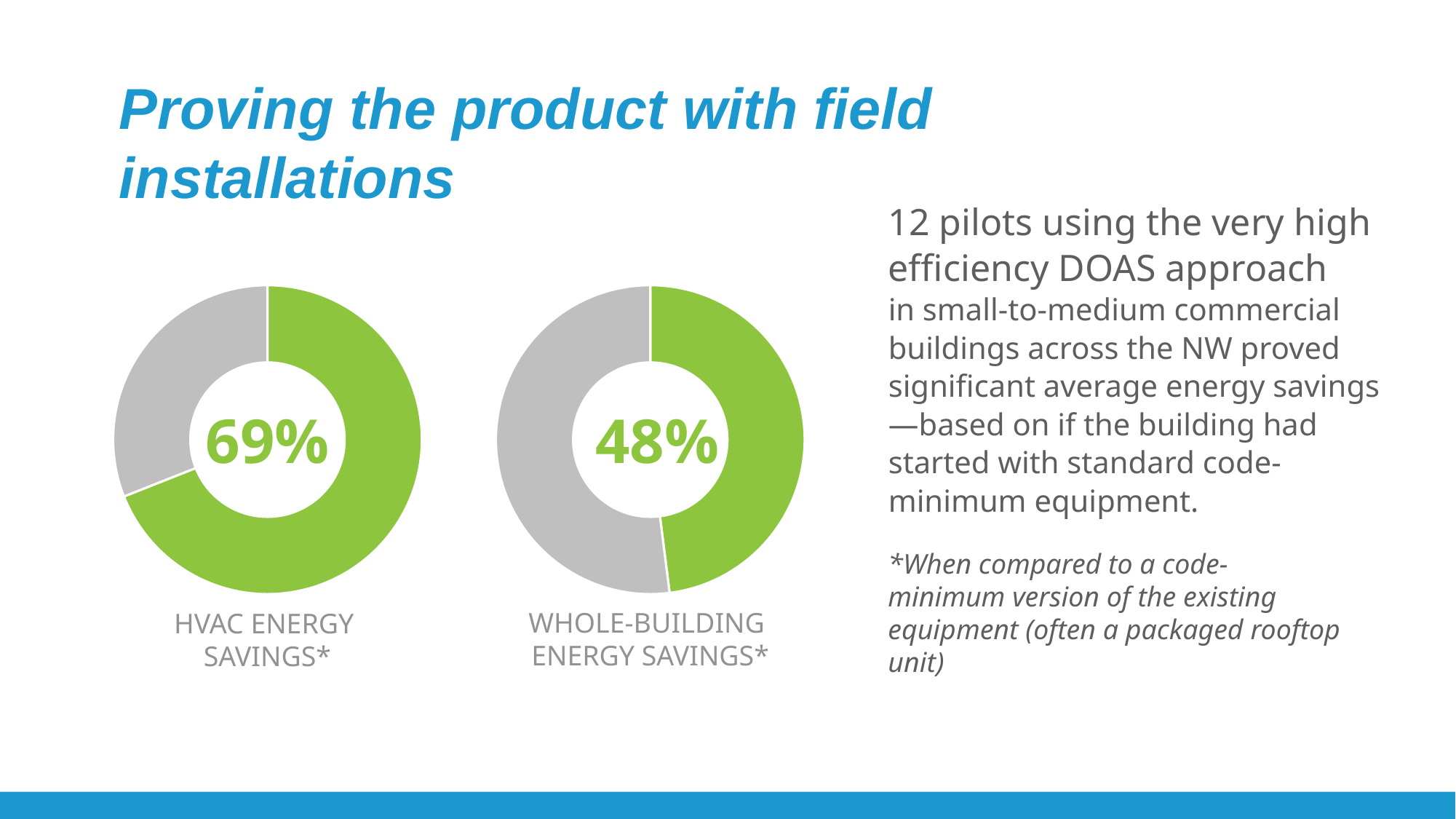
What kind of chart is used to show the HVAC Energy Savings value? Donut chart What is the difference in percentage points between the HVAC Energy Savings value and the Whole-Building Energy Savings value? 21 How many donut charts are shown on the slide? 2 What colour is used for the savings portion in both donut charts? Green Which of the two donut charts shows the lower savings percentage? Whole-Building Energy Savings In the HVAC Energy Savings donut chart, is the green portion greater or less than 50%? greater Which of the two donut charts shows the higher savings percentage, HVAC Energy Savings or Whole-Building Energy Savings? HVAC Energy Savings What value is shown in the centre of the HVAC Energy Savings donut chart? 69% What value is shown in the centre of the Whole-Building Energy Savings donut chart? 48% In the Whole-Building Energy Savings donut chart, is the green portion greater or less than 50%? less What is the label beneath the donut chart showing 48%? Whole-Building Energy Savings*